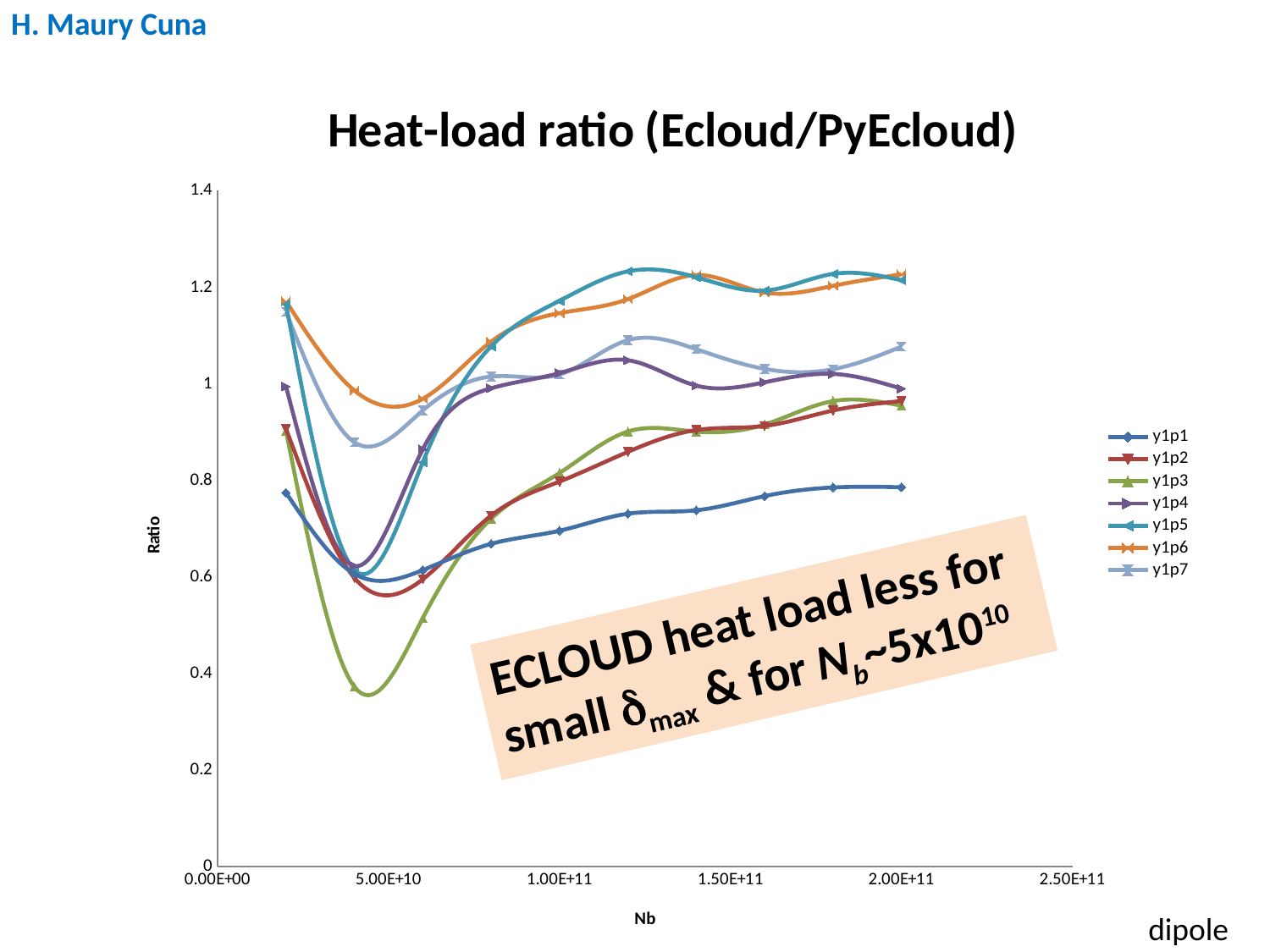
Which series has the lowest value at Nb = 5.00E+10? y1p3 Does the y1p1 series rise or fall between Nb = 5.00E+10 and Nb = 2.00E+11? rise Which series has the lowest value at Nb = 2.00E+11? y1p1 What is the title of the chart? Heat-load ratio (Ecloud/PyEcloud) Is the value for y1p6 at Nb = 2.00E+11 greater or less than 1? greater What kind of chart is shown on the slide? line chart Is the value for y1p3 at Nb = 5.00E+10 greater or less than 0.6? less Which series has the highest value at Nb = 5.00E+10? y1p6 Is the value for y1p1 at Nb = 2.00E+11 greater or less than 1? less At Nb = 2.00E+11, which is larger, the value for y1p5 or the value for y1p1? y1p5 How many series does the legend list? 7 What is the label of the y axis? Ratio